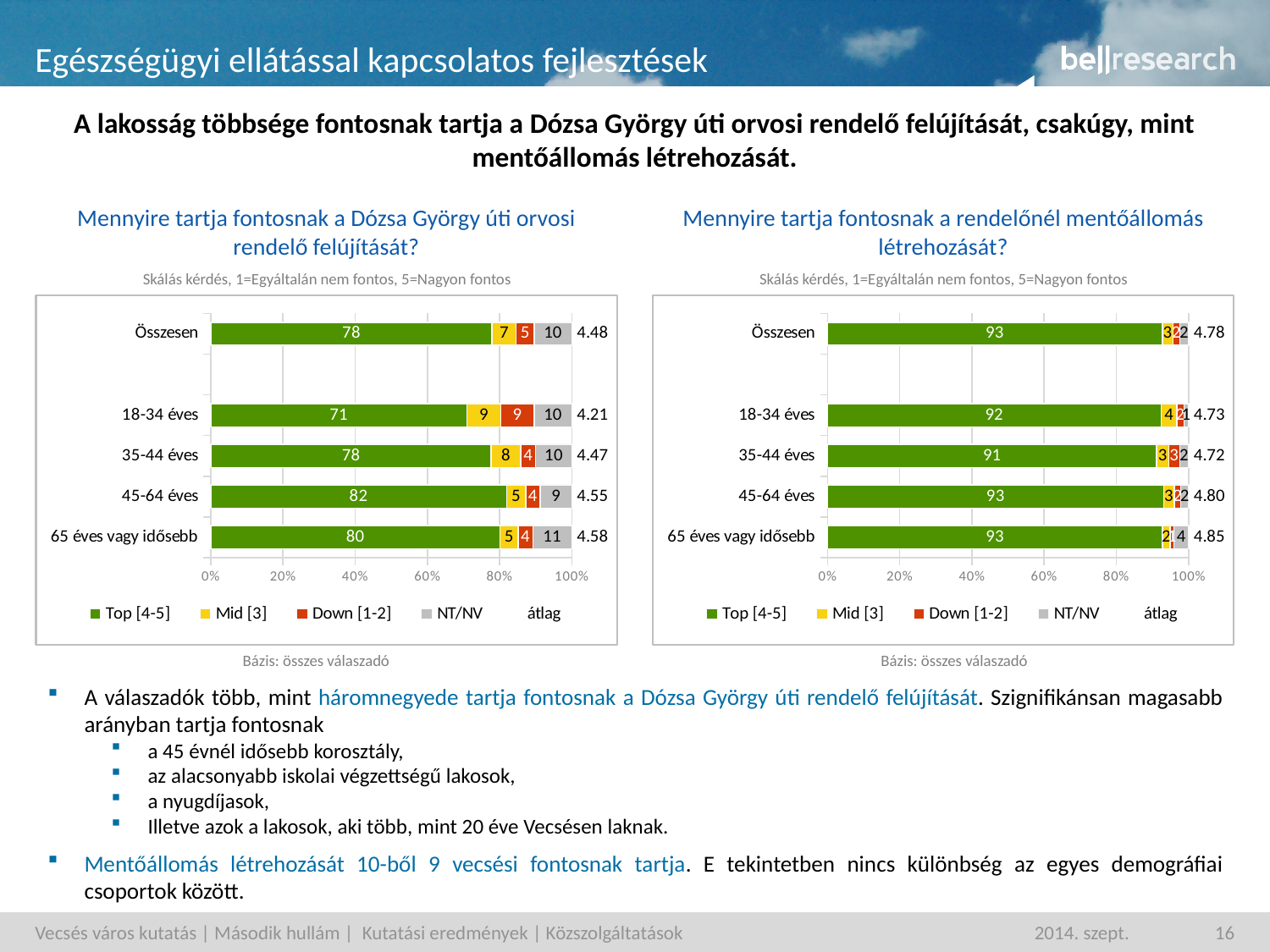
Which is larger: the Top [4-5] value for Összesen in the left chart or in the right chart? Right chart (93) In the right chart (mentőállomás létrehozása), what is the átlag (average) for 65 éves vagy idősebb? 4.85 In the left chart (Dózsa György úti orvosi rendelő felújítása), what is the átlag (average) for 18-34 éves? 4.21 In the left chart (Dózsa György úti orvosi rendelő felújítása), which age group has the highest Top [4-5] value? 45-64 éves What type of chart is used on this slide? Bar chart (stacked horizontal) In the left chart (Dózsa György úti orvosi rendelő felújítása), what is the Top [4-5] value for 45-64 éves? 82 How many categories (rows) are shown in the left chart? 5 In the left chart (Dózsa György úti orvosi rendelő felújítása), which age group has the lowest Top [4-5] value? 18-34 éves In the right chart (mentőállomás létrehozása), what is the Top [4-5] value for Összesen? 93 In the left chart (Dózsa György úti orvosi rendelő felújítása), what is the NT/NV value for 65 éves vagy idősebb? 11 In the left chart (Dózsa György úti orvosi rendelő felújítása), what is the difference between the Top [4-5] values for 45-64 éves and 18-34 éves? 11 In the right chart (mentőállomás létrehozása), which age group has the lowest Top [4-5] value? 35-44 éves